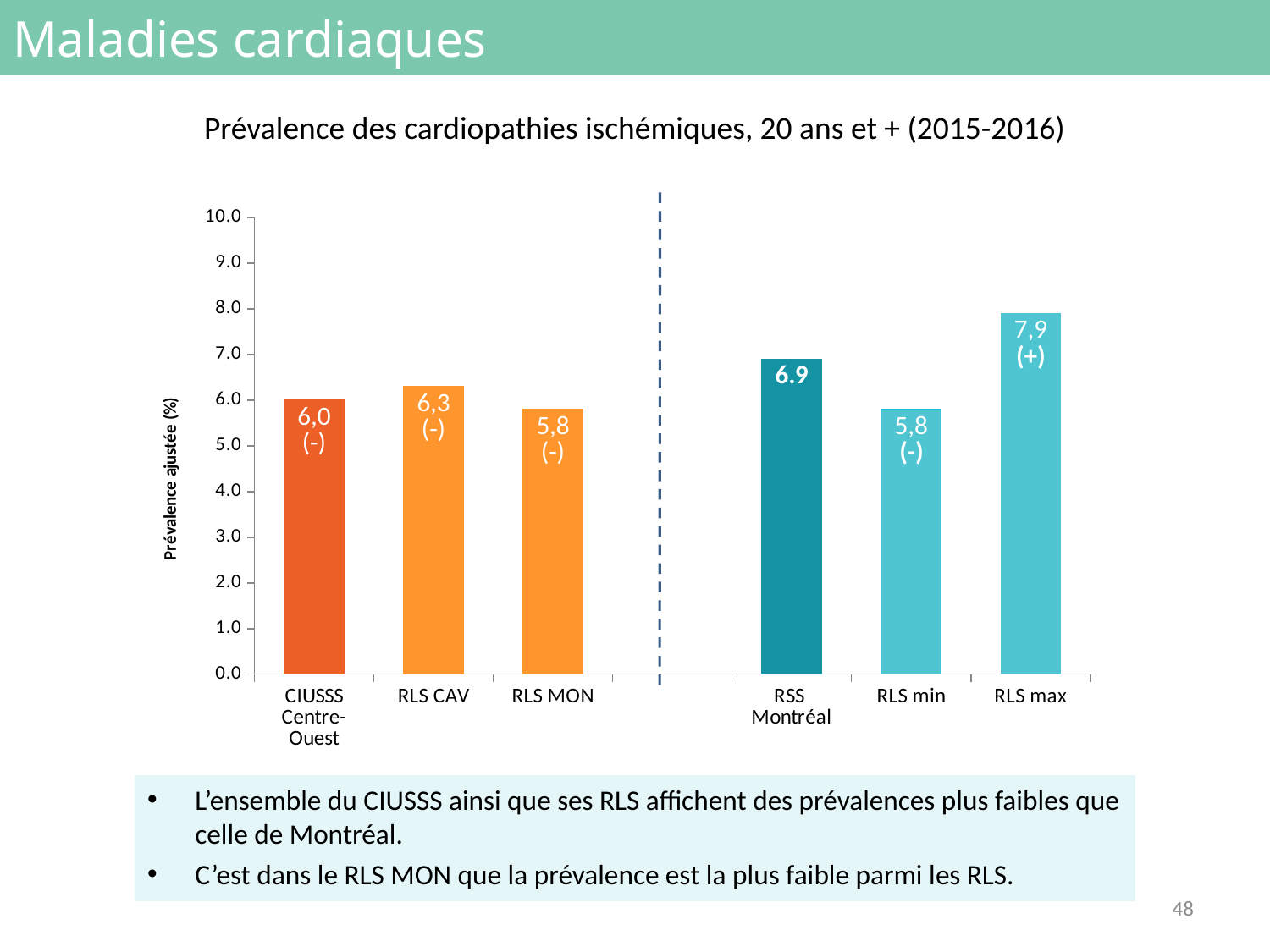
Which is larger, the value for RLS CAV or the value for CIUSSS Centre-Ouest? RLS CAV What is the value for RSS Montréal? 6.9 What is the title of the chart? Prévalence des cardiopathies ischémiques, 20 ans et + (2015-2016) What is the value for RLS max? 7,9 What type of chart is shown on the slide? bar chart Among CIUSSS Centre-Ouest, RLS CAV and RLS MON, which has the lowest value? RLS MON What is the label of the vertical axis? Prévalence ajustée (%) Which category has the highest value? RLS max How many bars are shown in the chart? 6 What is the value for CIUSSS Centre-Ouest? 6,0 What is the difference between the values for RLS max and RLS min? 2,1 What is the value for RLS CAV? 6,3